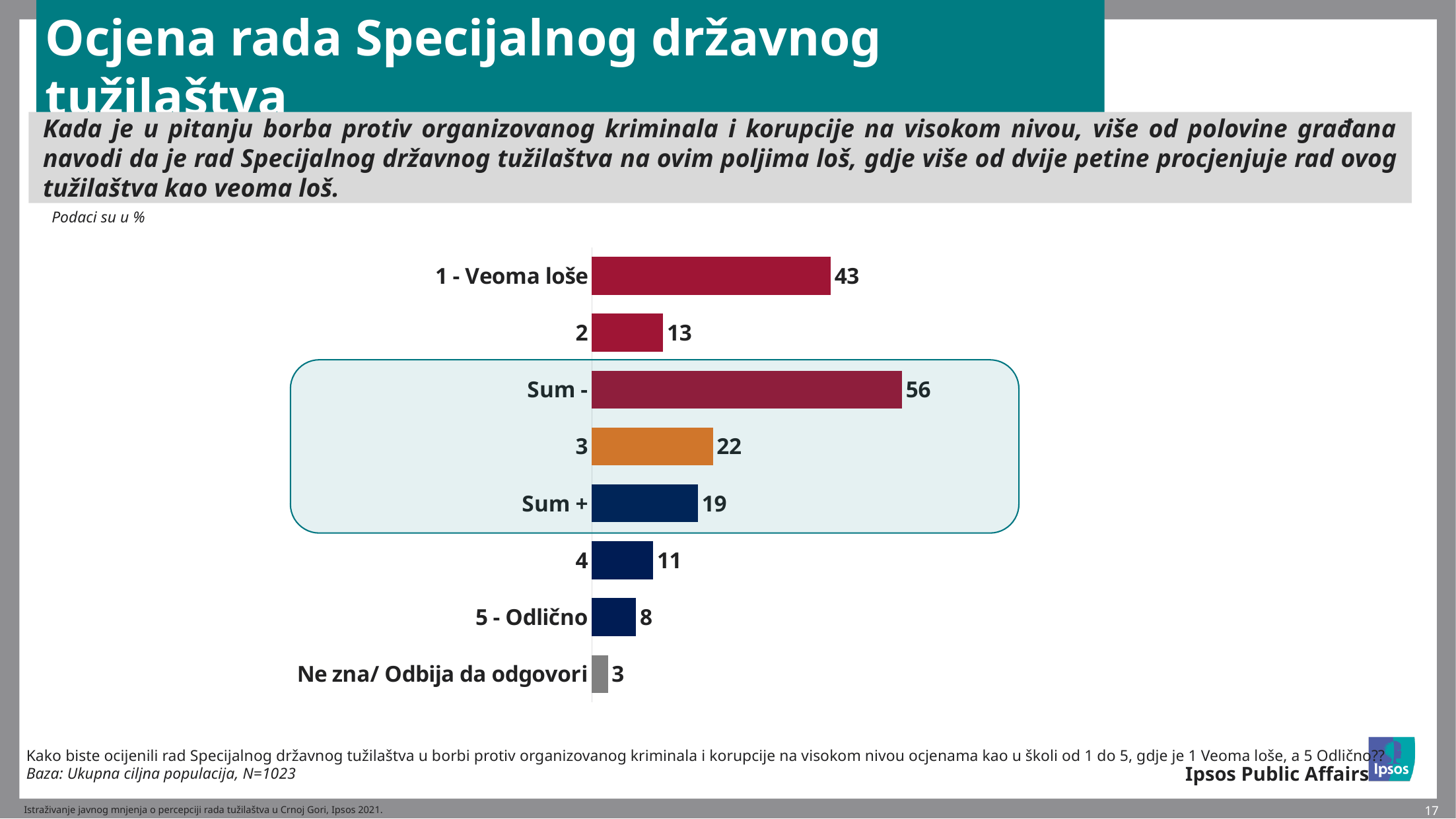
What is the value for "Sum -"? 56 What kind of chart is shown on the slide? Bar chart What is the value for "1 - Veoma loše"? 43 What is the difference between "Sum -" and "Sum +"? 37 What is the value for "Ne zna/ Odbija da odgovori"? 3 What is the value for "3"? 22 Which is larger, the value for "2" or the value for "4"? 2 What colour is the bar for "3"? Orange How many categories are shown in the chart? 8 Which category has the lowest value? Ne zna/ Odbija da odgovori What is the difference between "1 - Veoma loše" and "5 - Odlično"? 35 Which category has the highest value? Sum -